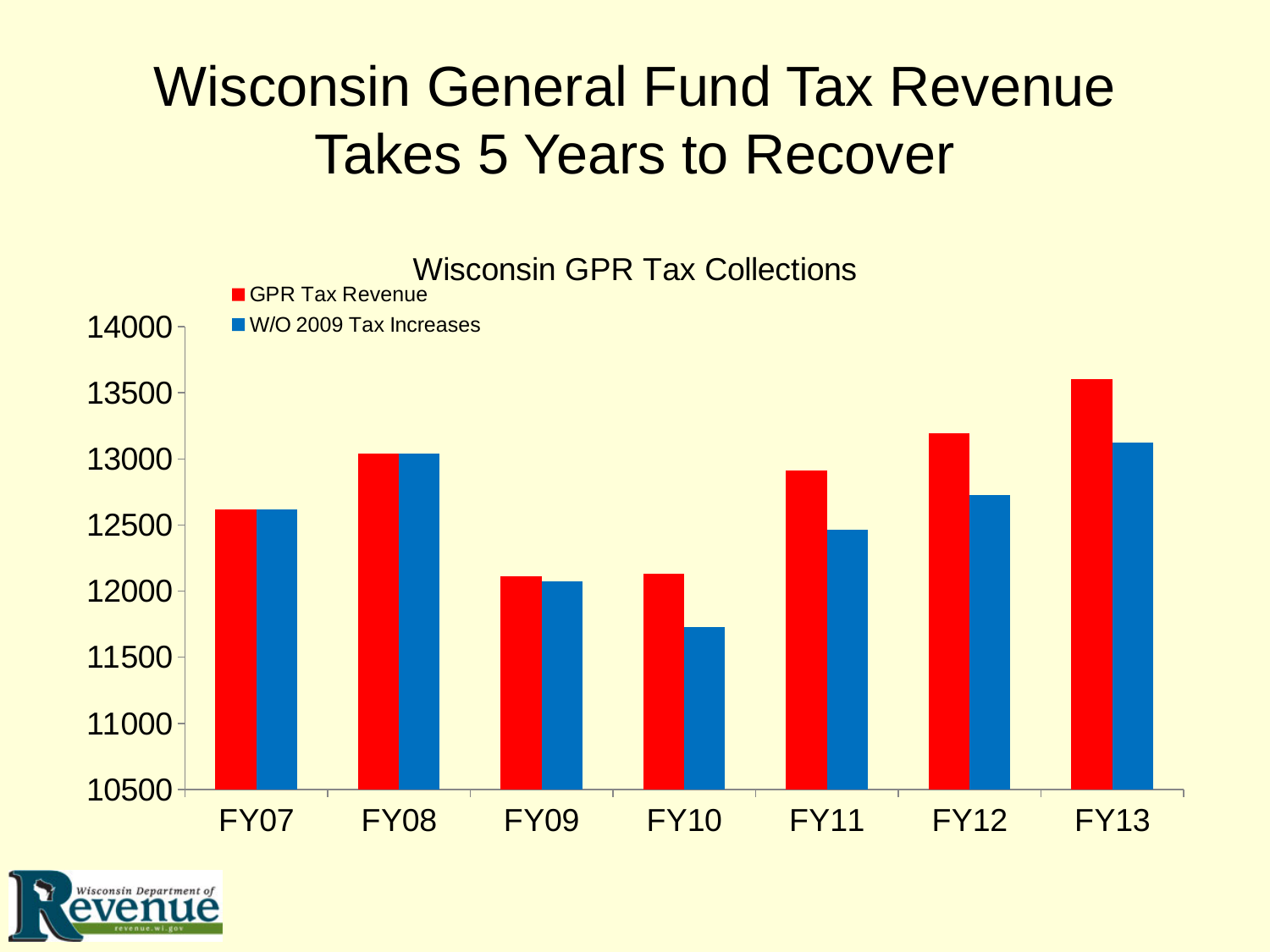
What kind of chart is shown on the slide? bar chart In FY11, which is larger: GPR Tax Revenue or W/O 2009 Tax Increases? GPR Tax Revenue Which colour represents the 'W/O 2009 Tax Increases' series? blue How many series does the chart's legend list? 2 Does GPR Tax Revenue rise or fall from FY10 to FY13? rise Is the GPR Tax Revenue value for FY13 greater or less than 13500? greater Is the 'W/O 2009 Tax Increases' value for FY10 greater or less than 12000? less How many fiscal years are shown on the x axis of the chart? 7 What is the title of the chart? Wisconsin GPR Tax Collections Is the GPR Tax Revenue value for FY11 greater or less than 13000? less In which fiscal year is the 'W/O 2009 Tax Increases' value lowest? FY10 In which fiscal year is GPR Tax Revenue highest? FY13